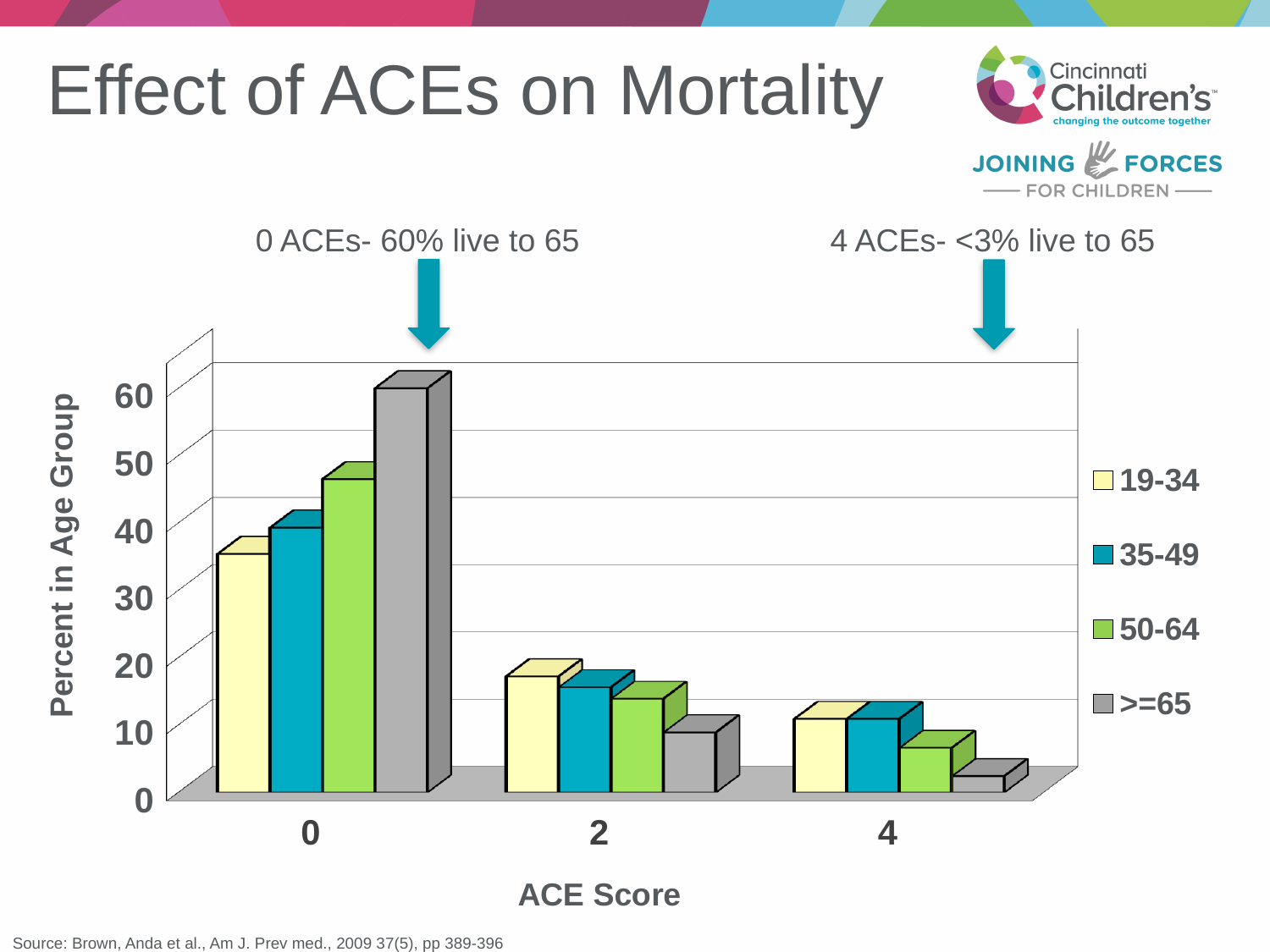
Which ACE Score has the highest value for the >=65 age group? 0 Which ACE Score has the lowest value for the >=65 age group? 4 What kind of chart is shown on the slide? bar chart Is the value for the >=65 age group at ACE Score 4 greater or less than 10? less Is the value for the 19-34 age group at ACE Score 0 greater or less than 30? greater Is the value for the 50-64 age group at ACE Score 2 greater or less than 20? less At ACE Score 0, which is larger: the value for 19-34 or the value for >=65? >=65 How many ACE Score categories are shown on the x axis? 3 What is the title of the y axis? Percent in Age Group How many series does the legend list? 4 Do the values for the >=65 age group rise or fall as the ACE Score increases from 0 to 4? fall